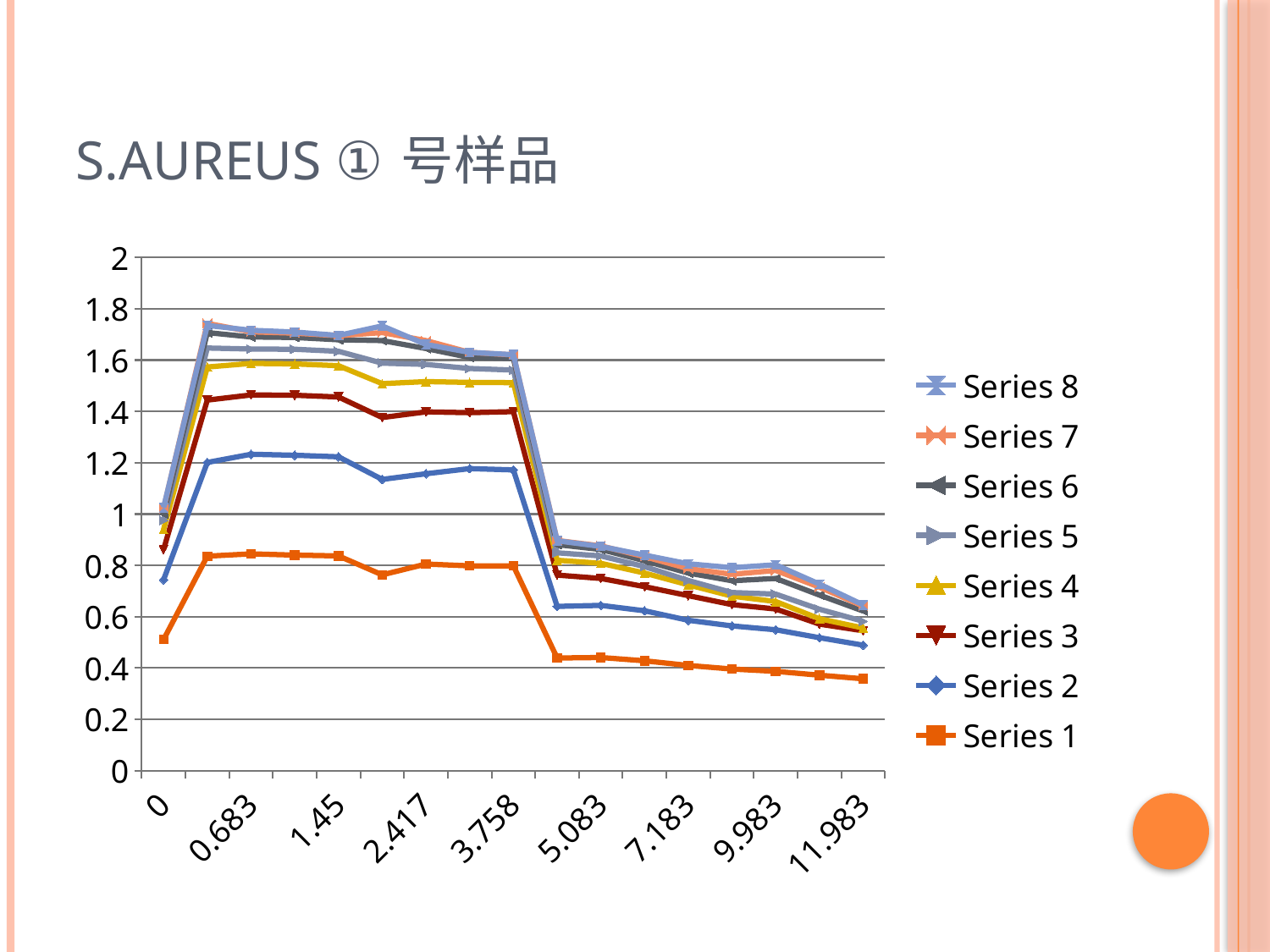
How many series does the legend list? 8 Is the value for Series 1 at x = 11.983 greater or less than 0.4? less Is the value for Series 8 at x = 0.683 greater or less than 1.6? greater Do the values of Series 1 rise or fall from x = 5.083 to x = 11.983? fall What kind of chart is shown on the slide? line chart Is the value for Series 1 at x = 0 greater or less than 0.4? greater At x = 5.083, which is larger: Series 2 or Series 3? Series 3 Which series has the lowest values across the whole chart? Series 1 What is the title of the slide containing the chart? S.AUREUS ① 号样品 How many x-axis tick labels are shown on the chart? 9